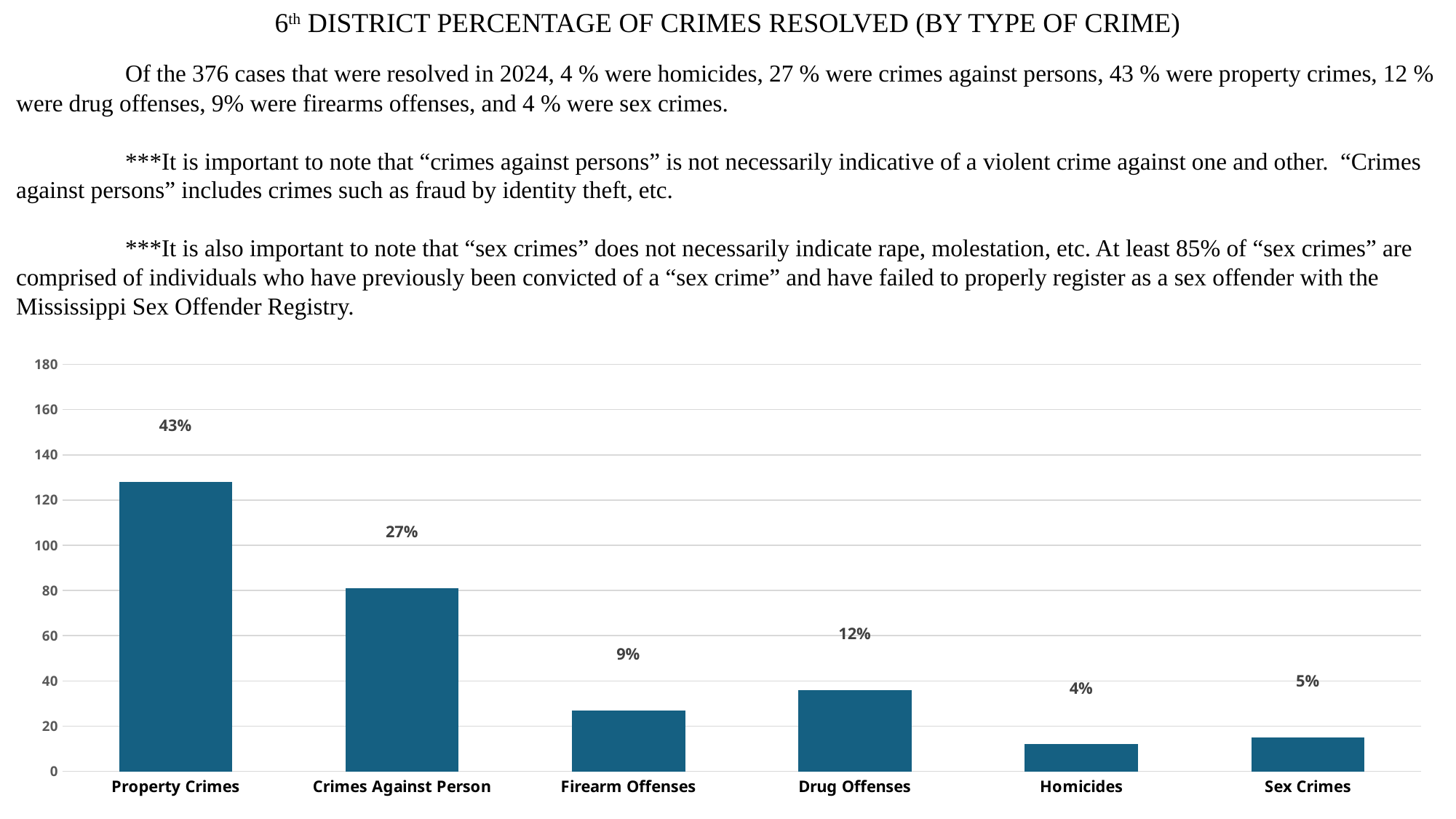
Is the bar for Homicides greater or less than 20 on the vertical axis? less How many crime types are shown on the x axis of the chart? 6 What percentage label is shown above the Drug Offenses bar? 12% Is the bar for Property Crimes greater or less than 120 on the vertical axis? greater What is the difference in percentage points between the labels for Property Crimes and Crimes Against Person? 16 Which has a higher labelled percentage, Drug Offenses or Firearm Offenses? Drug Offenses What percentage label is shown above the Firearm Offenses bar? 9% What kind of chart is shown on the slide? Bar chart Which crime type has the shortest bar in the chart? Homicides What percentage label is shown above the Crimes Against Person bar? 27% Which crime type has the tallest bar in the chart? Property Crimes What percentage label is shown above the Property Crimes bar? 43%